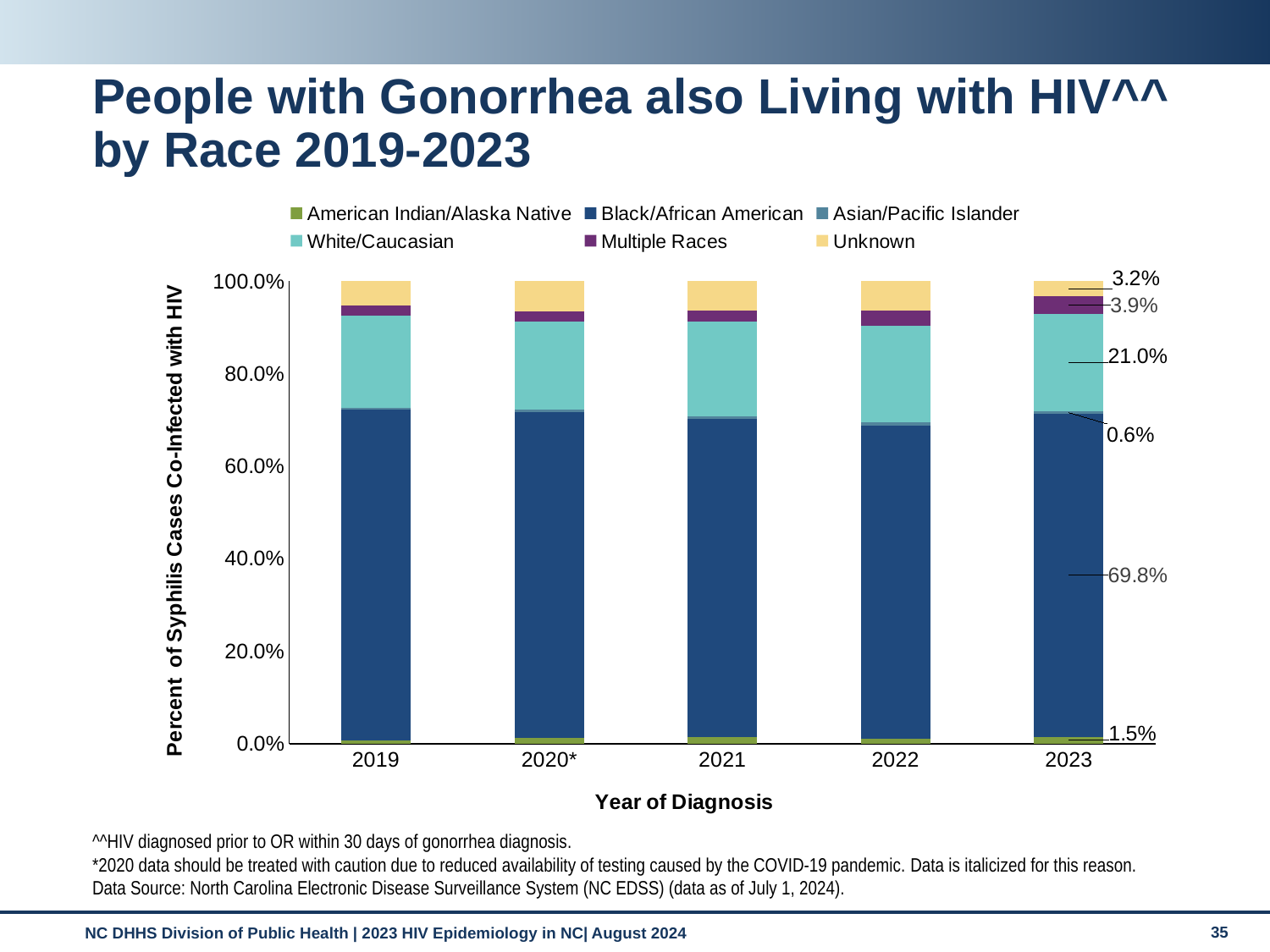
How many series does the legend list? 6 What is the value for Black/African American in 2023? 69.8% What type of chart is shown on the slide? stacked bar chart What is the value for Unknown in 2023? 3.2% What is the value for Asian/Pacific Islander in 2023? 0.6% What is the value for American Indian/Alaska Native in 2023? 1.5% What is the value for Multiple Races in 2023? 3.9% Which race group has the largest share in 2023? Black/African American Which race group has the smallest share in 2023? Asian/Pacific Islander What is the difference between the Black/African American and White/Caucasian values in 2023? 48.8% How many years are shown on the x axis? 5 What is the value for White/Caucasian in 2023? 21.0%